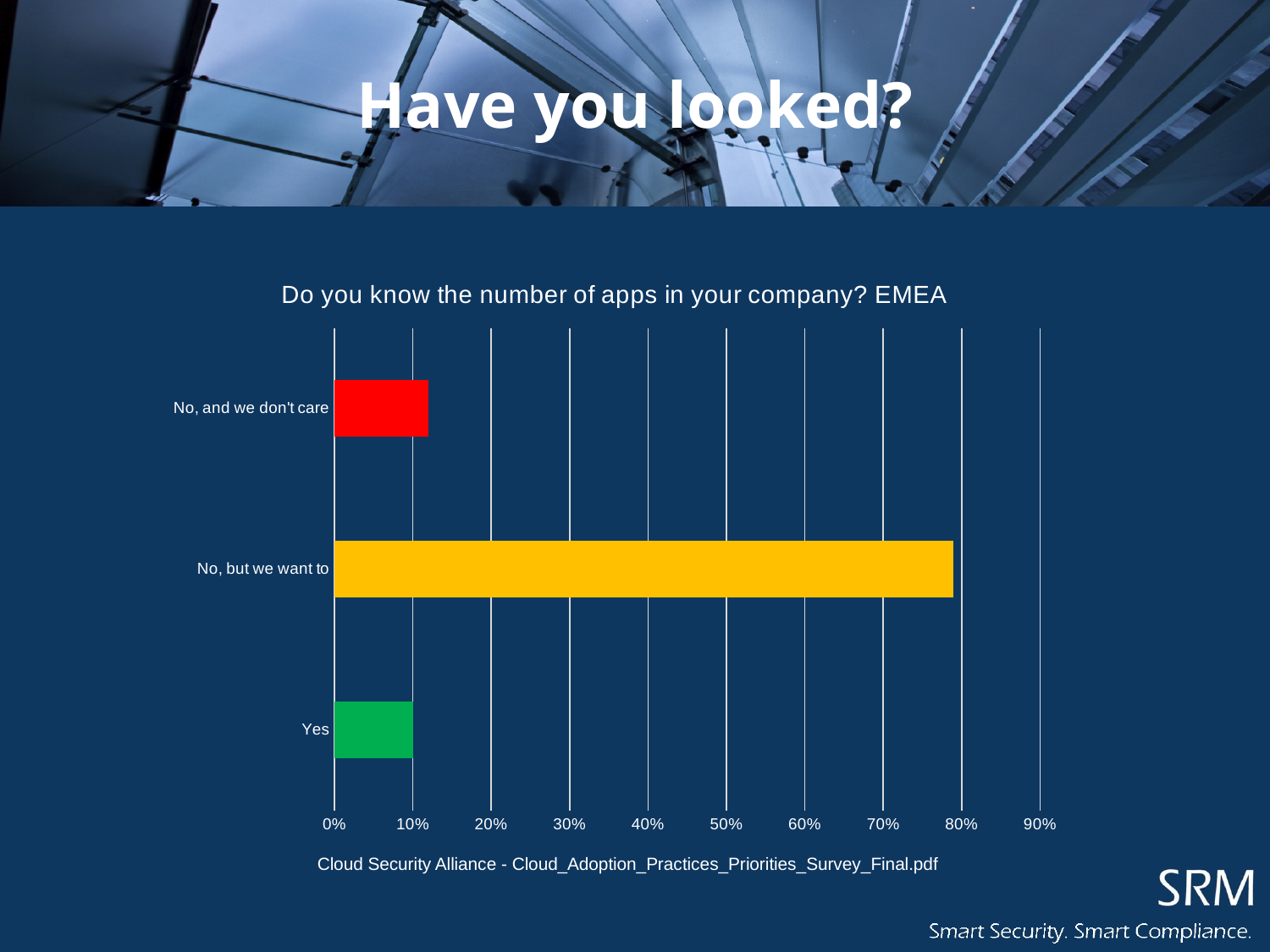
What colour is the bar for "No, but we want to"? Yellow Is the value for "Yes" greater or less than 20%? less What type of chart is shown on the slide? Bar chart Is the value for "No, but we want to" greater or less than 80%? less Which is larger, the value for "No, but we want to" or the value for "No, and we don't care"? No, but we want to How many categories are shown in the chart? 3 Which is larger, the value for "No, but we want to" or the value for "Yes"? No, but we want to What is the value for "Yes"? 10% What is the title of the chart? Do you know the number of apps in your company? EMEA Which category has the highest value? No, but we want to Is the value for "No, and we don't care" greater or less than 20%? less